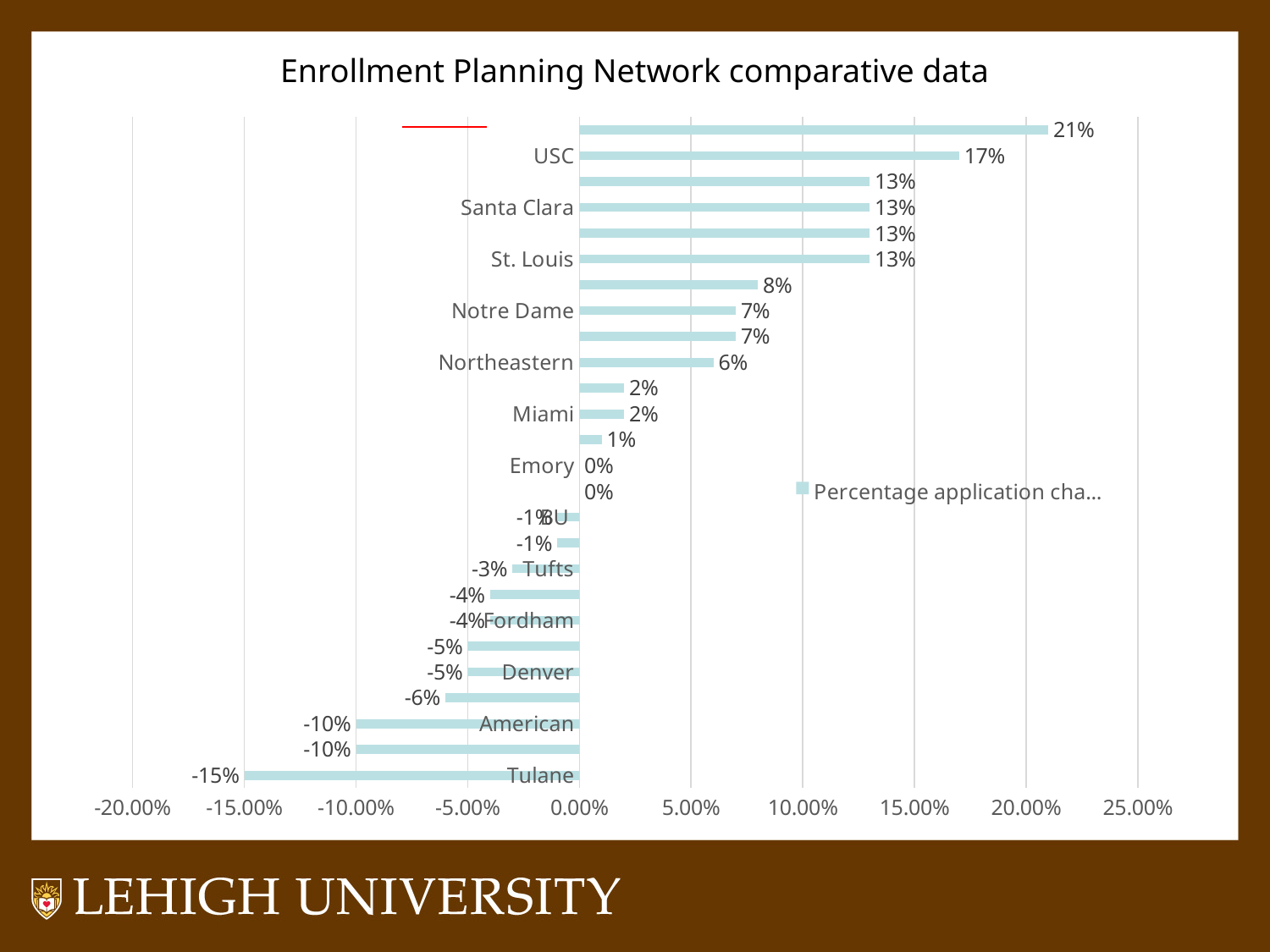
What is the value for American? -10% What is the value for Santa Clara? 13% How many bars are plotted in the chart? 26 What is the value for USC? 17% What is the value for Tulane? -15% What is the difference between the values for USC and Santa Clara? 4 percentage points What kind of chart is shown on the slide? Bar chart Which labeled category has the lowest value? Tulane What is the title of the chart? Enrollment Planning Network comparative data What is the value for Notre Dame? 7% What is the value for Emory? 0% Which is larger, the value for Notre Dame or the value for Northeastern? Notre Dame